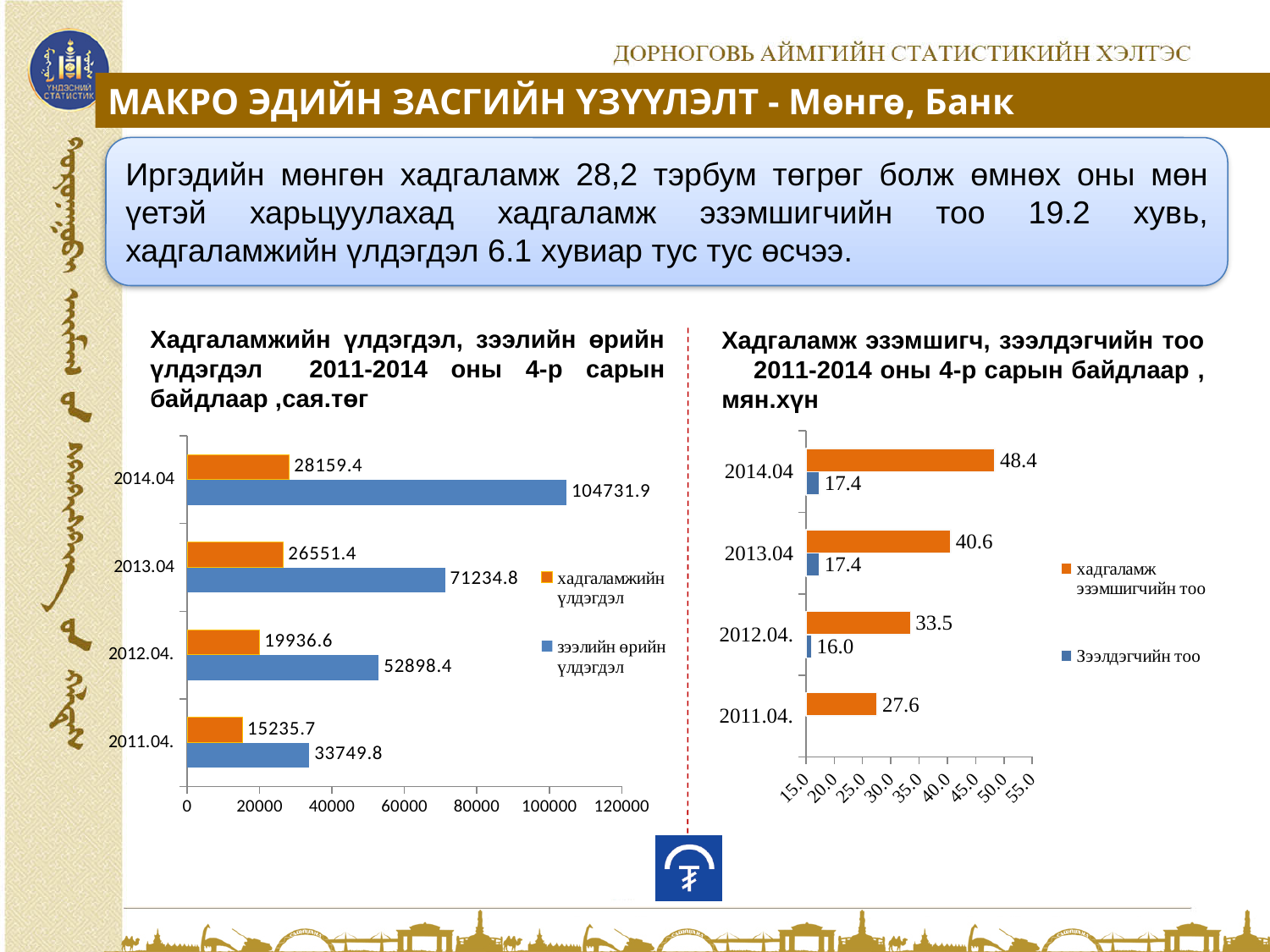
In the right chart (Хадгаламж эзэмшигч, зээлдэгчийн тоо), which period has the lowest хадгаламж эзэмшигчийн тоо? 2011.04 In the left chart (Хадгаламжийн үлдэгдэл, зээлийн өрийн үлдэгдэл), does хадгаламжийн үлдэгдэл rise or fall from 2011.04 to 2014.04? rise In the left chart (Хадгаламжийн үлдэгдэл, зээлийн өрийн үлдэгдэл), what is the value of зээлийн өрийн үлдэгдэл for 2014.04? 104731.9 In the right chart (Хадгаламж эзэмшигч, зээлдэгчийн тоо), what is the difference between хадгаламж эзэмшигчийн тоо in 2014.04 and 2013.04? 7.8 What type of chart is the left chart (Хадгаламжийн үлдэгдэл, зээлийн өрийн үлдэгдэл)? bar chart In the left chart (Хадгаламжийн үлдэгдэл, зээлийн өрийн үлдэгдэл), what is the value of хадгаламжийн үлдэгдэл for 2011.04? 15235.7 In the left chart (Хадгаламжийн үлдэгдэл, зээлийн өрийн үлдэгдэл), what is the difference between хадгаламжийн үлдэгдэл in 2014.04 and 2013.04? 1608.0 In the right chart (Хадгаламж эзэмшигч, зээлдэгчийн тоо), how many periods are shown on the vertical axis? 4 In the left chart (Хадгаламжийн үлдэгдэл, зээлийн өрийн үлдэгдэл), how many series does the legend list? 2 In the left chart (Хадгаламжийн үлдэгдэл, зээлийн өрийн үлдэгдэл), which period has the highest зээлийн өрийн үлдэгдэл? 2014.04 In the right chart (Хадгаламж эзэмшигч, зээлдэгчийн тоо), what is the value of Зээлдэгчийн тоо for 2012.04? 16.0 In the right chart (Хадгаламж эзэмшигч, зээлдэгчийн тоо), what is the value of хадгаламж эзэмшигчийн тоо for 2014.04? 48.4